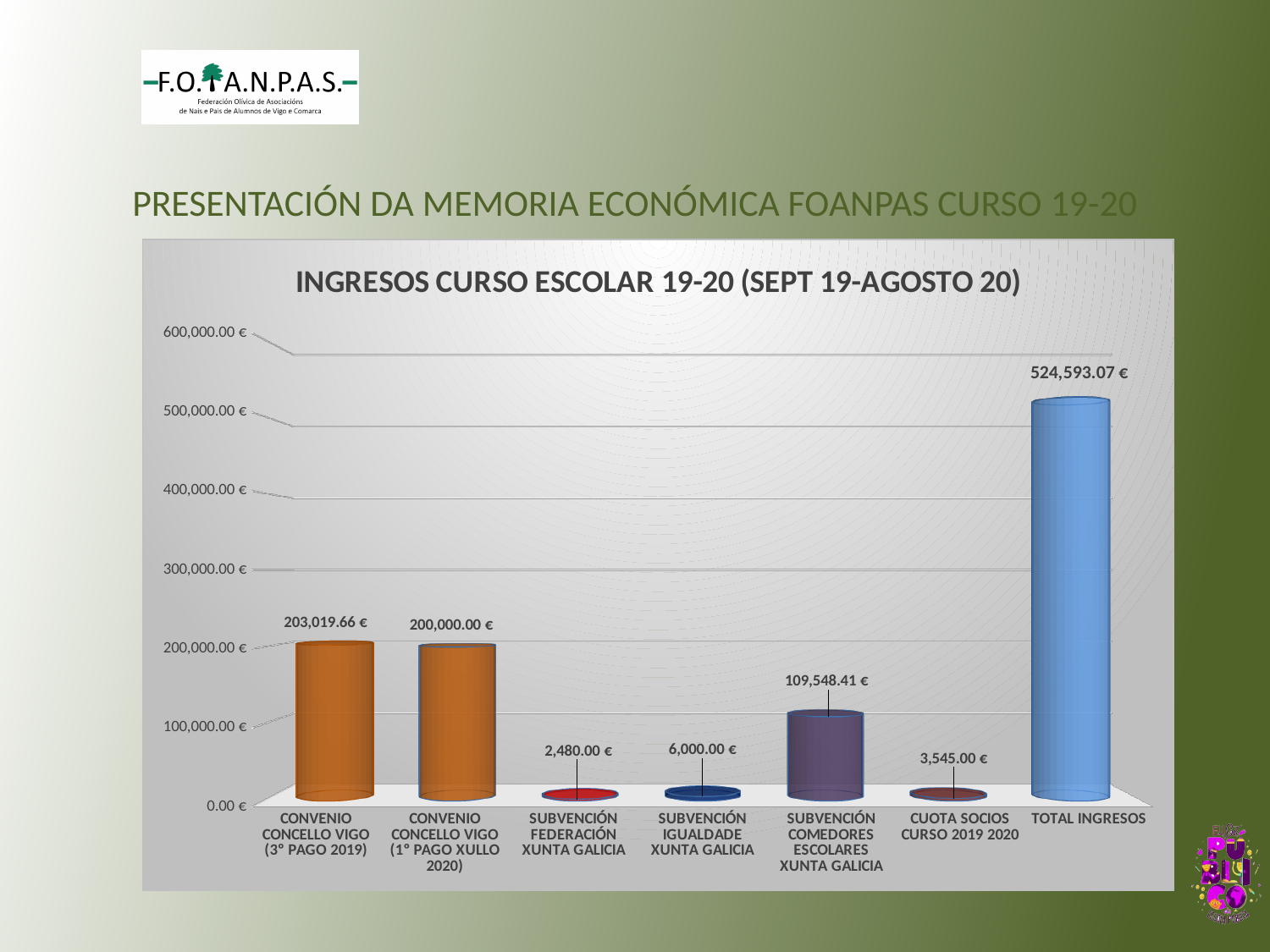
Which category has the lowest value? SUBVENCIÓN FEDERACIÓN XUNTA GALICIA What is the value for TOTAL INGRESOS? 524,593.07 € Which category has the highest value? TOTAL INGRESOS Is the value for SUBVENCIÓN COMEDORES ESCOLARES XUNTA GALICIA greater or less than 100,000.00 €? greater What is the value for SUBVENCIÓN COMEDORES ESCOLARES XUNTA GALICIA? 109,548.41 € How many categories are shown on the x axis? 7 What is the value for CONVENIO CONCELLO VIGO (1º PAGO XULLO 2020)? 200,000.00 € What is the difference between CONVENIO CONCELLO VIGO (3º PAGO 2019) and CONVENIO CONCELLO VIGO (1º PAGO XULLO 2020)? 3,019.66 € What is the value for CUOTA SOCIOS CURSO 2019 2020? 3,545.00 € Which is larger, SUBVENCIÓN IGUALDADE XUNTA GALICIA or CUOTA SOCIOS CURSO 2019 2020? SUBVENCIÓN IGUALDADE XUNTA GALICIA What kind of chart is shown on the slide? bar chart What is the difference between SUBVENCIÓN IGUALDADE XUNTA GALICIA and SUBVENCIÓN FEDERACIÓN XUNTA GALICIA? 3,520.00 €